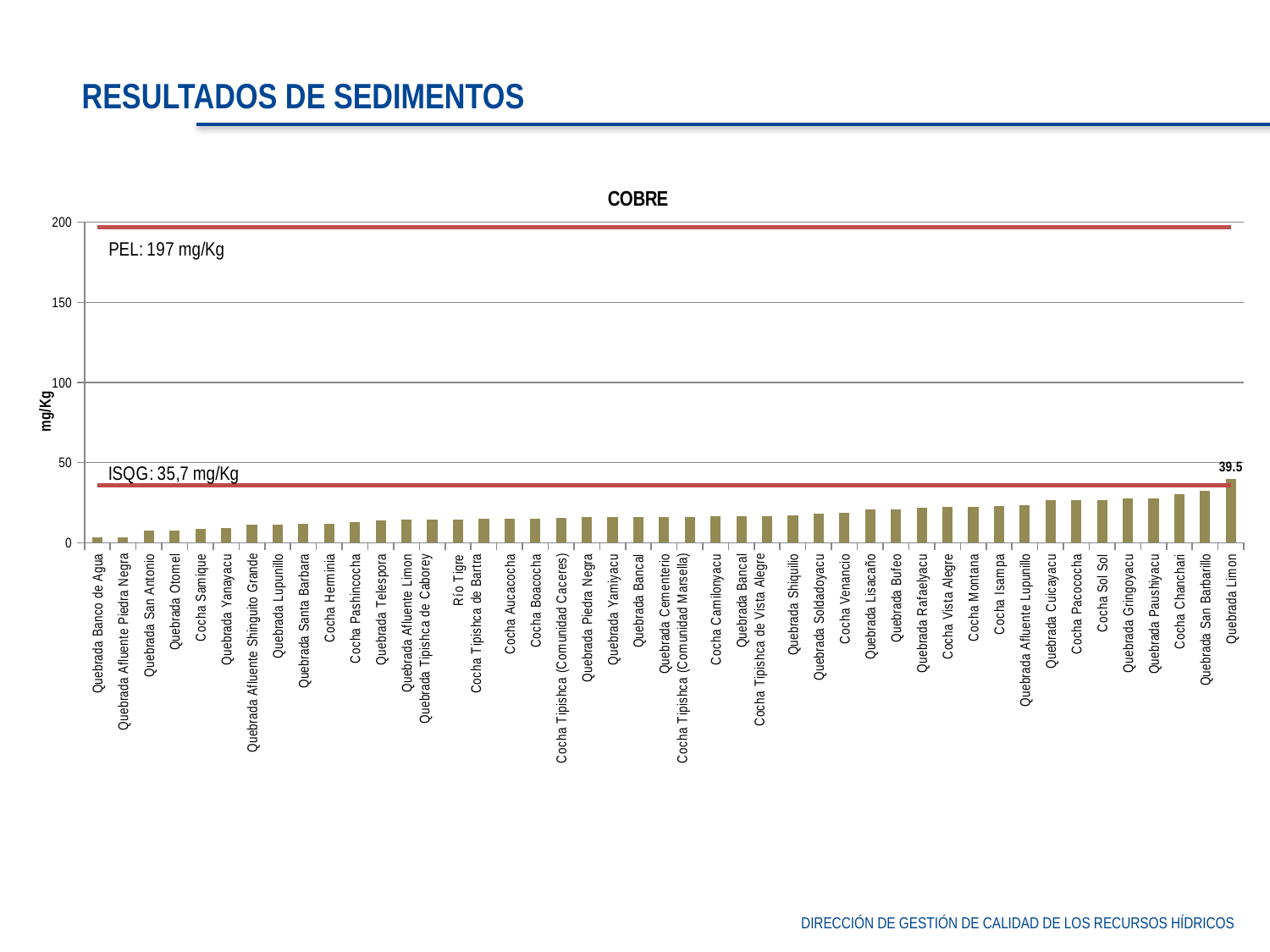
What kind of chart is shown? bar chart Which site has the highest copper value? Quebrada Limon What is the value for Quebrada Limon? 39.5 Do the bar values rise or fall from left to right along the x axis? rise What is the PEL reference value shown on the chart? 197 mg/Kg What is the ISQG reference value shown on the chart? 35,7 mg/Kg Which is larger, the value for Cocha Chanchari or the value for Cocha Samique? Cocha Chanchari How many sites are plotted on the chart? 45 Does any bar exceed the PEL line of 197 mg/Kg? No Is the value for Cocha Chanchari greater or less than 50? less Is the value for Quebrada Limon greater or less than 50? less Which is larger, the value for Quebrada Limon or the value for Quebrada Banco de Agua? Quebrada Limon